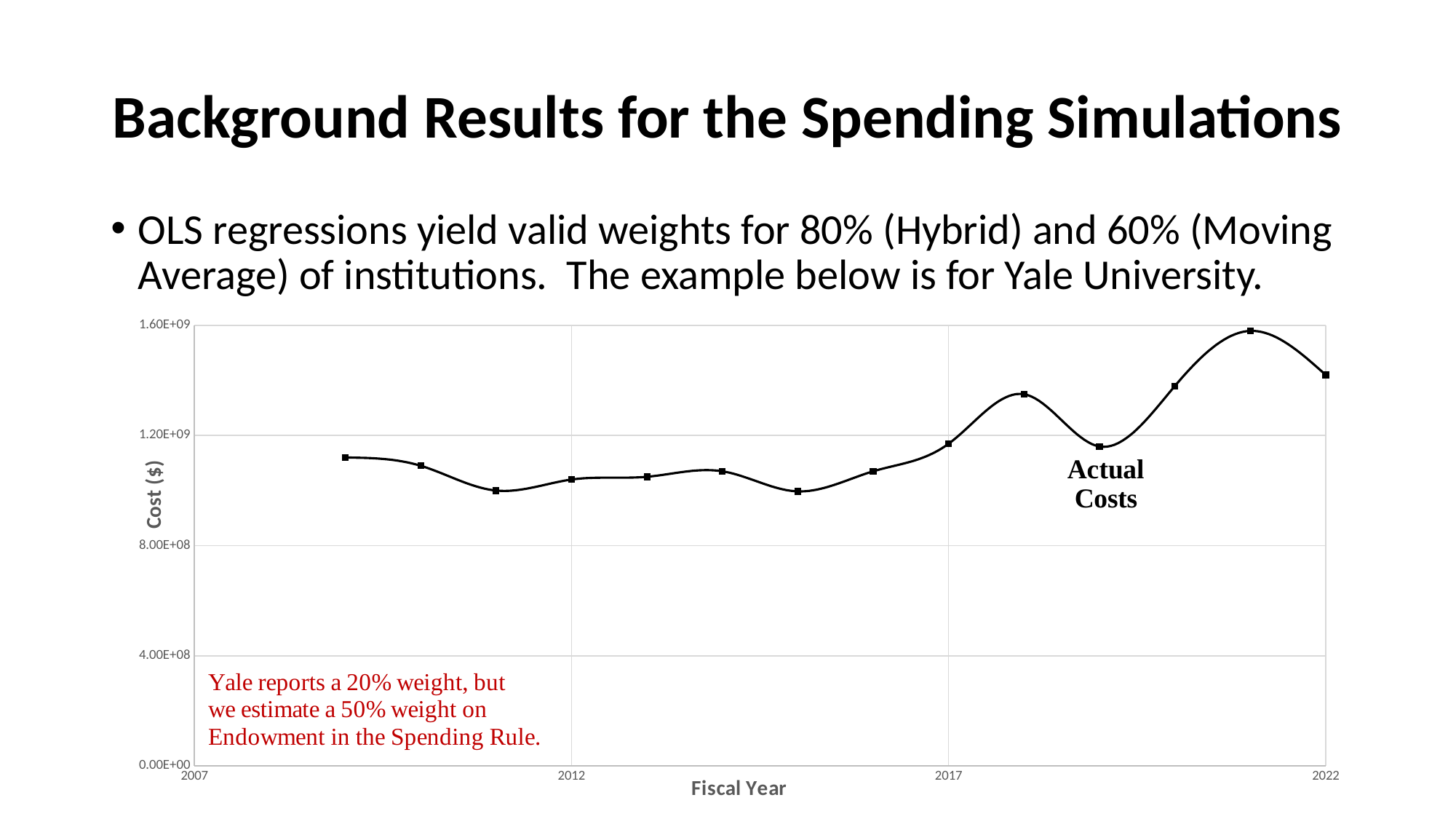
Overall, do the values rise or fall from fiscal year 2015 to fiscal year 2021? rise Is the value for fiscal year 2011 greater or less than 1.20E+09? less In which fiscal year does the line reach its highest value? 2021 What kind of chart is shown on the slide? line chart Is the value for fiscal year 2018 greater or less than 1.20E+09? greater How many data points are plotted on the line? 14 What is the title of the y axis of the chart? Cost ($) What is the title of the x axis of the chart? Fiscal Year Is the value for fiscal year 2021 greater or less than 1.20E+09? greater Which fiscal year has the larger value, 2018 or 2019? 2018 Which fiscal year has the larger value, 2009 or 2022? 2022